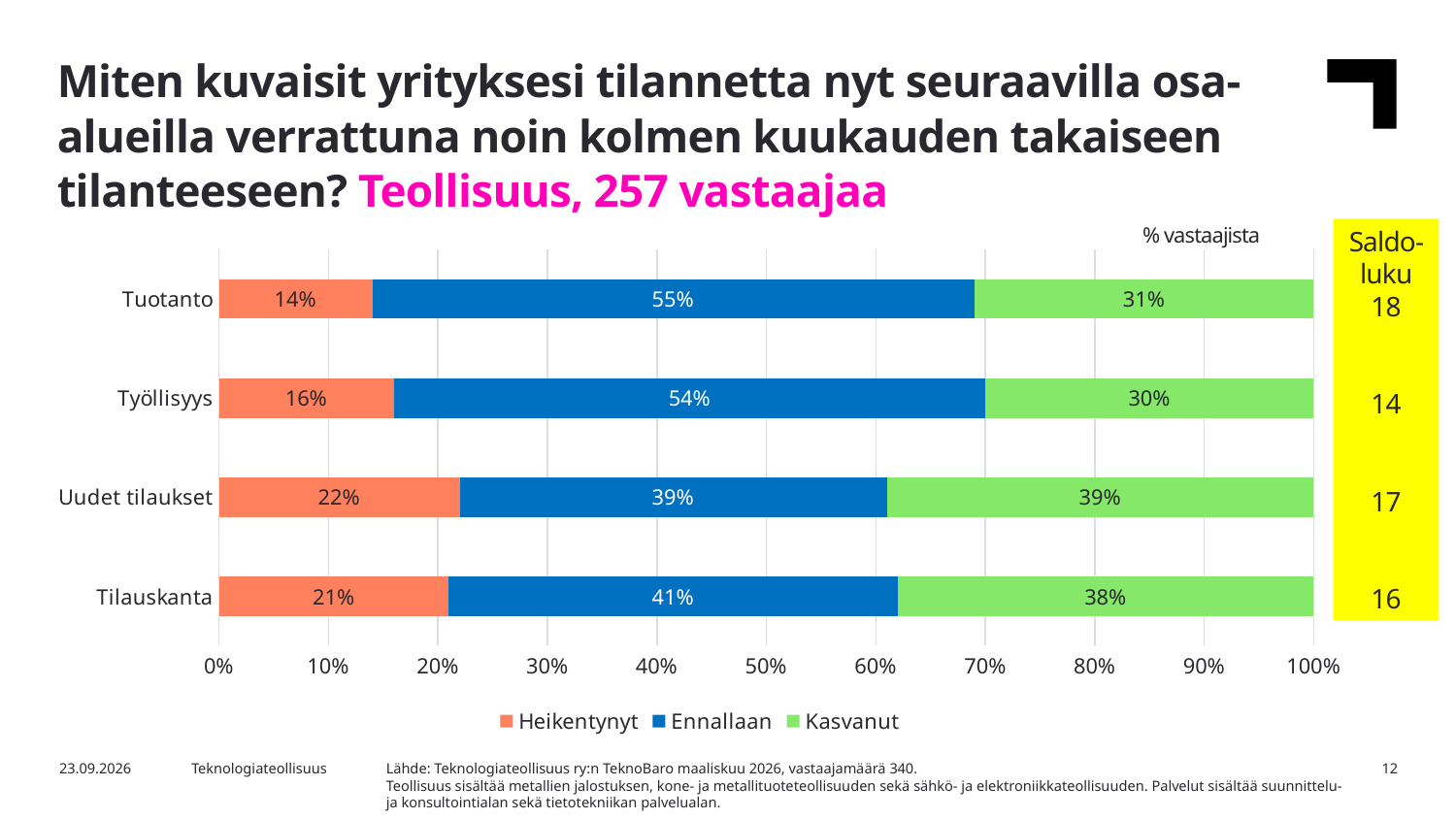
Which category has the highest 'Ennallaan' share? Tuotanto What kind of chart is shown on the slide? Stacked bar chart What is the Saldoluku value shown for Työllisyys? 14 How many categories are shown on the y axis of the chart? 4 Which series is shown in green in the legend? Kasvanut Which category has the lowest 'Heikentynyt' share? Tuotanto What is the 'Heikentynyt' value for Uudet tilaukset? 22% What is the difference between the 'Kasvanut' values for Uudet tilaukset and Tilauskanta? 1% What is the 'Ennallaan' value for Tilauskanta? 41% What percentage of respondents reported 'Kasvanut' for Tuotanto? 31% Which is larger: the 'Heikentynyt' value for Työllisyys or for Tilauskanta? Tilauskanta How many series does the legend list? 3